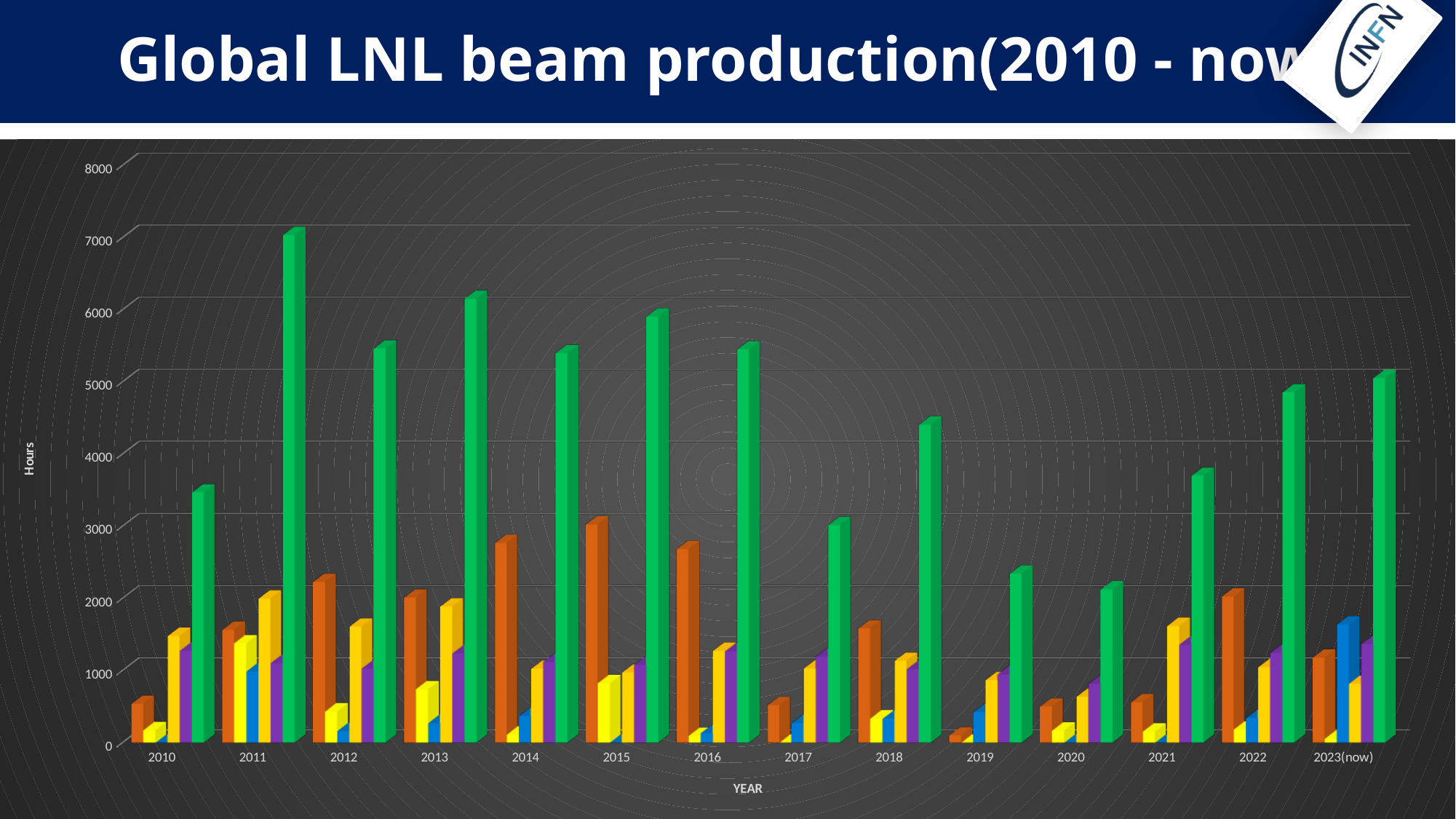
Which year has the taller green bar, 2010 or 2018? 2018 Is the green bar for 2010 greater or less than 4000? less In which year is the green bar the tallest? 2011 Which year has the taller green bar, 2011 or 2013? 2011 Is the green bar for 2019 greater or less than 3000? less How many years (categories) are shown on the x axis of the chart? 14 What kind of chart is shown on the slide? bar chart What is the label of the vertical axis of the chart? Hours What is the title of the chart on the slide? Global LNL beam production(2010 - now) Is the green bar for 2018 greater or less than 4000? greater Do the green bars rise or fall from 2020 to 2023(now)? rise